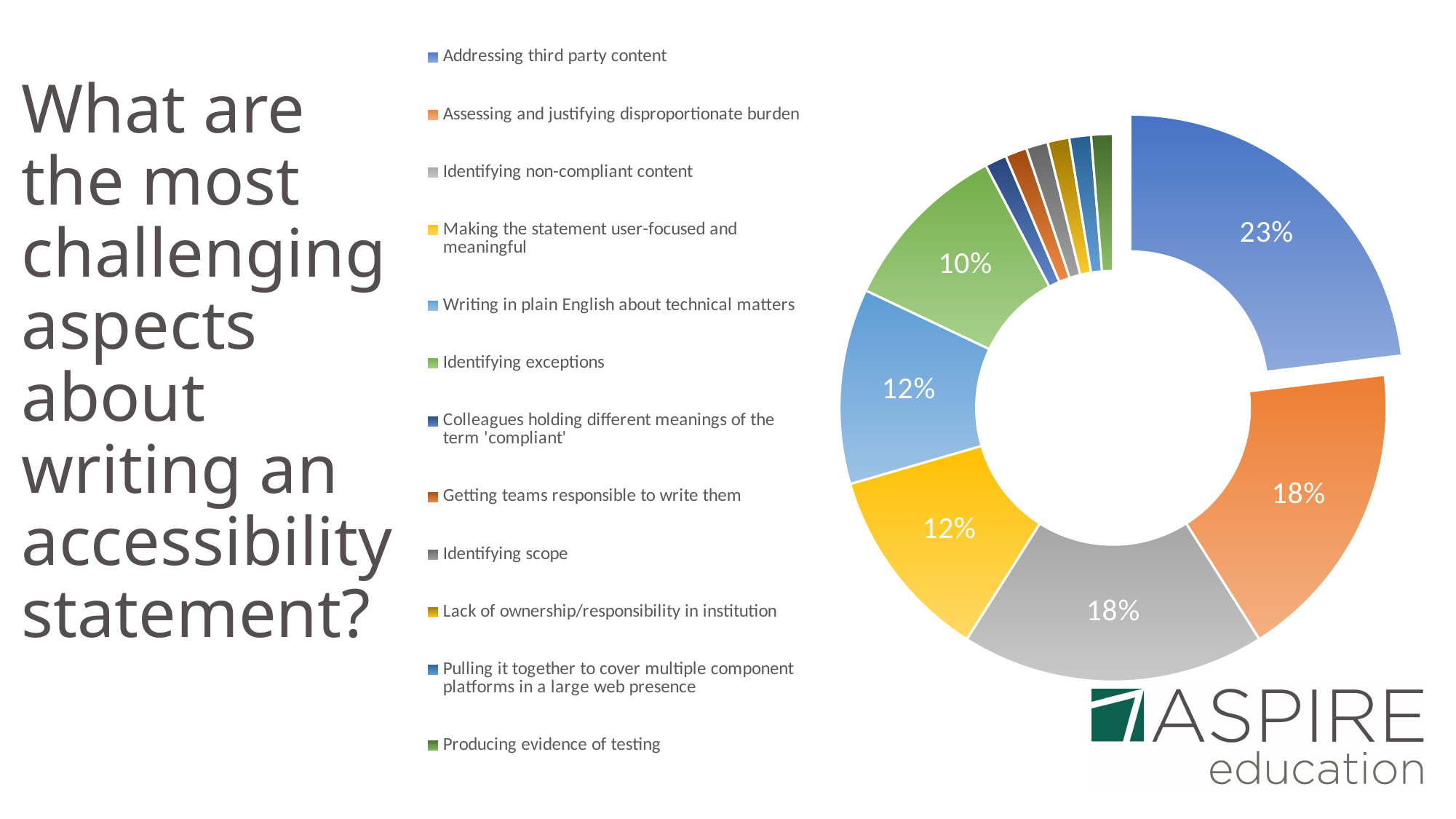
What kind of chart is shown on the slide? doughnut chart How many categories does the legend of the pie chart list? 12 What percentage is shown for 'Identifying exceptions'? 10% What share does 'Assessing and justifying disproportionate burden' have in the pie chart? 18% What percentage is shown for 'Identifying non-compliant content'? 18% What percentage is shown for 'Making the statement user-focused and meaningful'? 12% What percentage of the pie chart is for 'Addressing third party content'? 23% What is the difference in percentage points between 'Addressing third party content' and 'Identifying non-compliant content'? 5 percentage points What percentage is shown for 'Writing in plain English about technical matters'? 12% Which category has the largest slice of the pie chart? Addressing third party content What question does the slide title ask? What are the most challenging aspects about writing an accessibility statement? Which is larger: the slice for 'Writing in plain English about technical matters' or the slice for 'Identifying exceptions'? Writing in plain English about technical matters